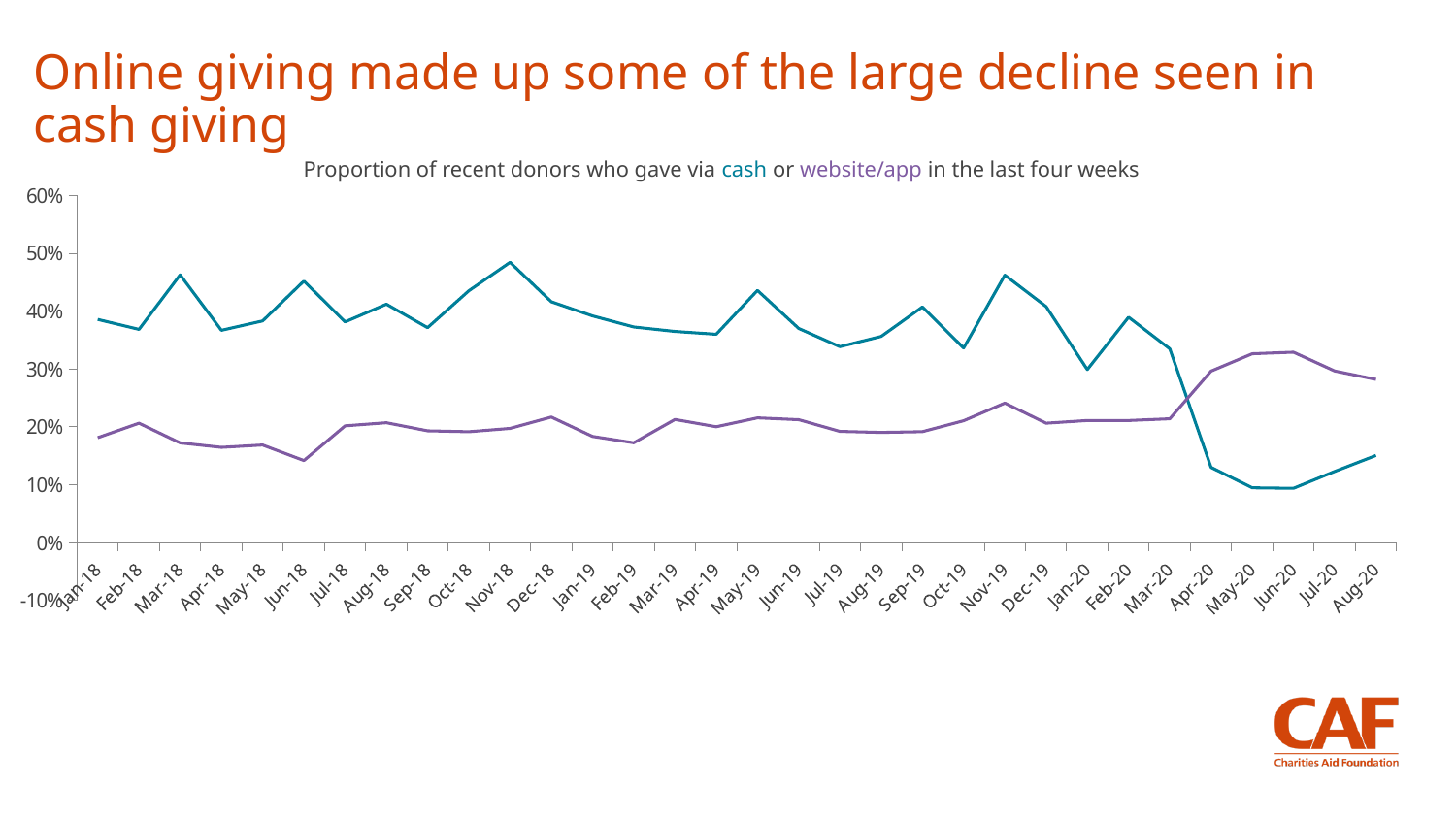
Is the value for cash in May-20 greater or less than 20%? less In Jan-18, which series has the higher value, cash or website/app? cash How many series does the chart plot? 2 Is the value for website/app in Jun-18 greater or less than 20%? less In Aug-20, which series has the higher value, cash or website/app? website/app Is the value for website/app in May-20 greater or less than 30%? greater Does the cash line rise or fall between Mar-20 and May-20? fall In which month does the cash line reach its highest value? Nov-18 How many monthly data points are shown along the x axis? 32 What is the chart's subtitle describing the plotted data? Proportion of recent donors who gave via cash or website/app in the last four weeks What kind of chart is shown on the slide? Line chart